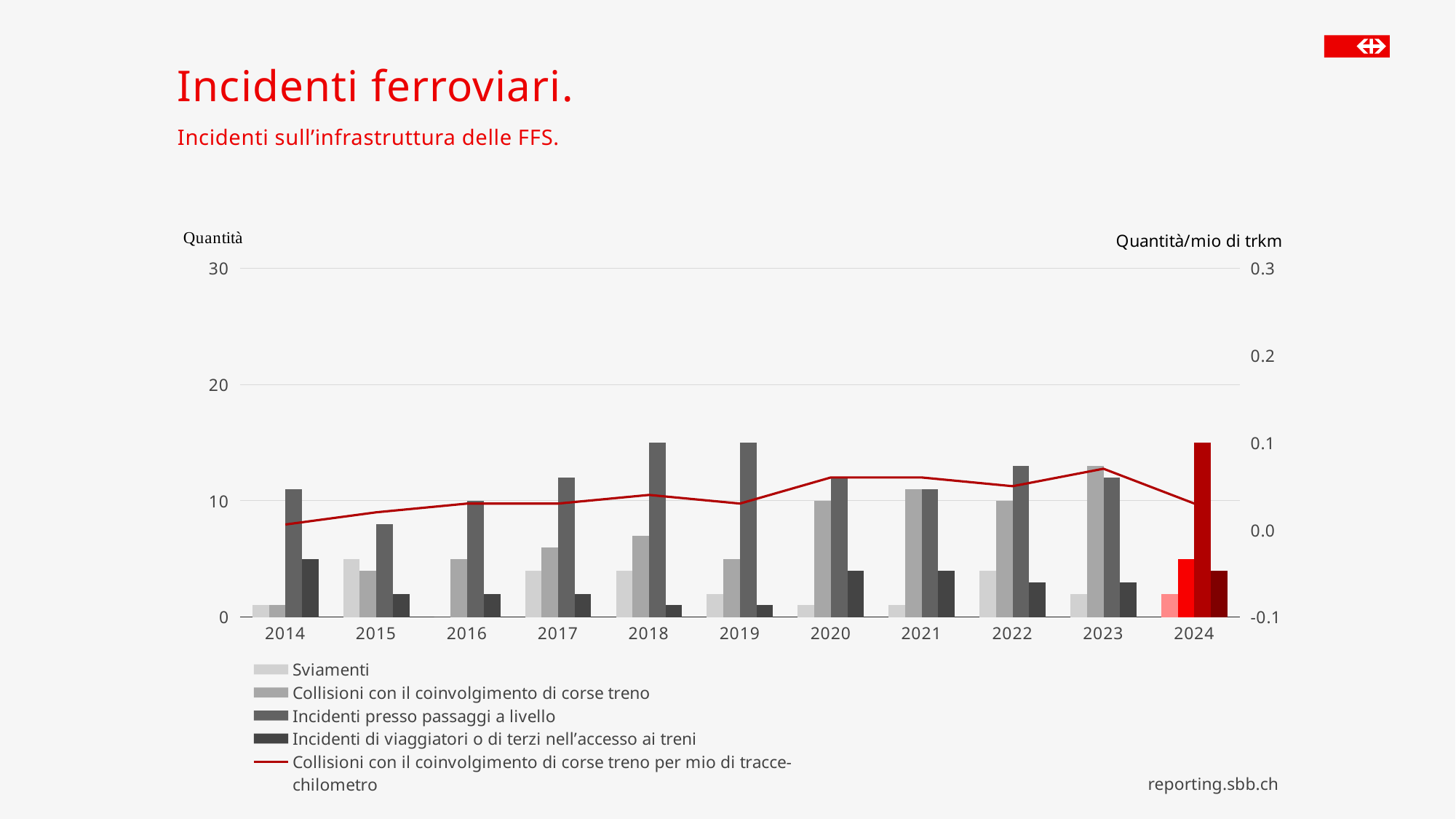
In which year is the Collisioni con il coinvolgimento di corse treno bar highest? 2023 How many series does the legend list? 5 Is the value for Collisioni con il coinvolgimento di corse treno in 2023 greater or less than 10? greater Is the 2023 value of the line Collisioni con il coinvolgimento di corse treno per mio di tracce-chilometro greater or less than 0.1? less Does the line Collisioni con il coinvolgimento di corse treno per mio di tracce-chilometro rise or fall from 2014 to 2020? rise Is the value for Incidenti presso passaggi a livello in 2018 greater or less than 10? greater In which year is the Incidenti presso passaggi a livello bar lowest? 2015 What kind of chart is shown on the slide? bar chart with a line Which is larger, the Incidenti presso passaggi a livello bar for 2018 or for 2015? 2018 Which is larger, the Sviamenti bar for 2014 or for 2015? 2015 How many years are shown on the x axis of the chart? 11